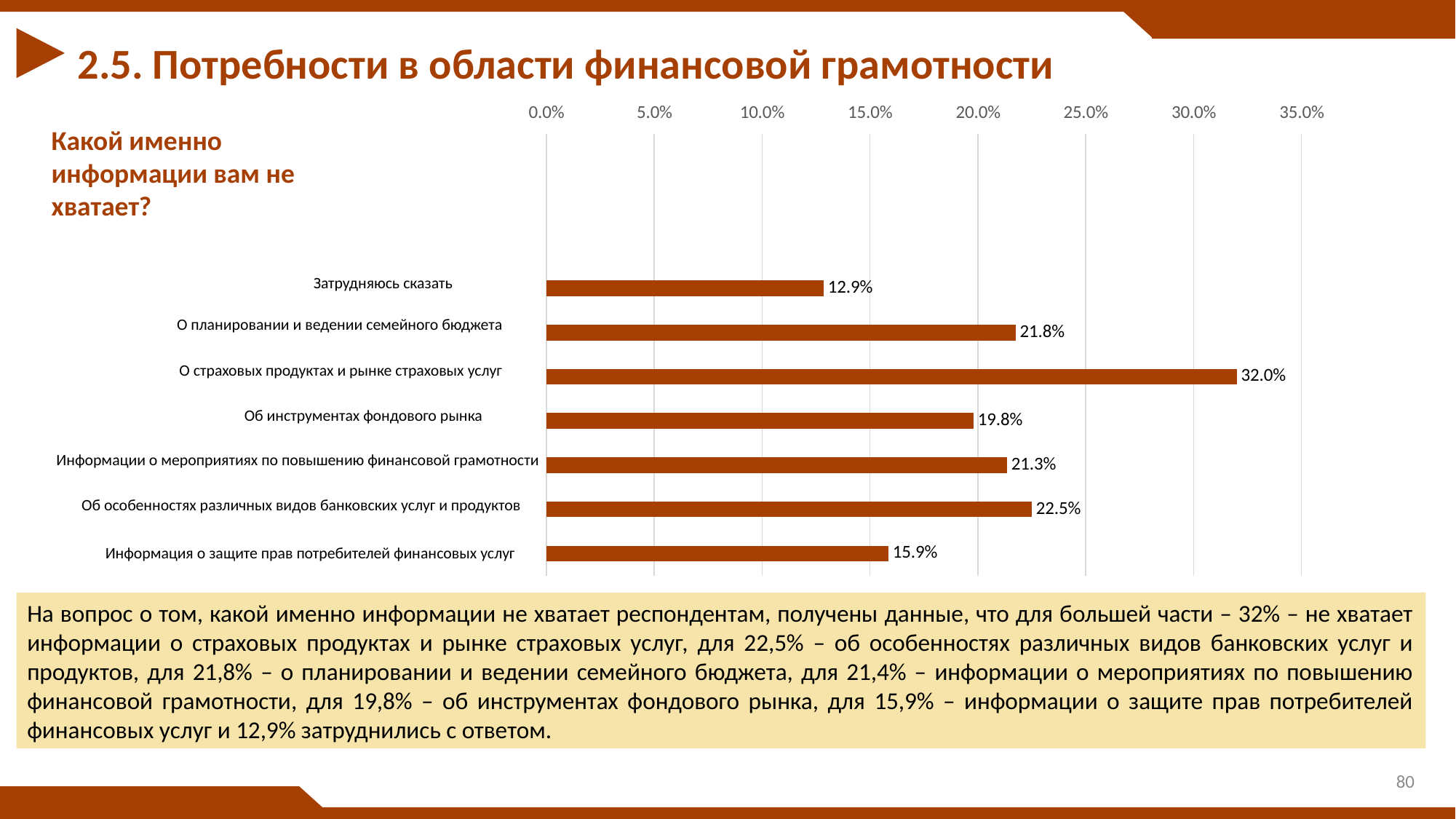
What kind of chart is shown on the slide? bar chart Is the value for «Об инструментах фондового рынка» greater or less than 20.0%? less What question is the chart titled with? Какой именно информации вам не хватает? What value is shown for «Информация о защите прав потребителей финансовых услуг»? 15.9% What value is shown for «О страховых продуктах и рынке страховых услуг»? 32.0% What is the difference between the values for «О страховых продуктах и рынке страховых услуг» and «Об особенностях различных видов банковских услуг и продуктов»? 9.5% Which is larger: the value for «О планировании и ведении семейного бюджета» or for «Информации о мероприятиях по повышению финансовой грамотности»? О планировании и ведении семейного бюджета Which category has the lowest value? Затрудняюсь сказать What value is shown for «Об инструментах фондового рынка»? 19.8% Which category has the highest value? О страховых продуктах и рынке страховых услуг How many categories are shown in the chart? 7 What value is shown for «Затрудняюсь сказать»? 12.9%